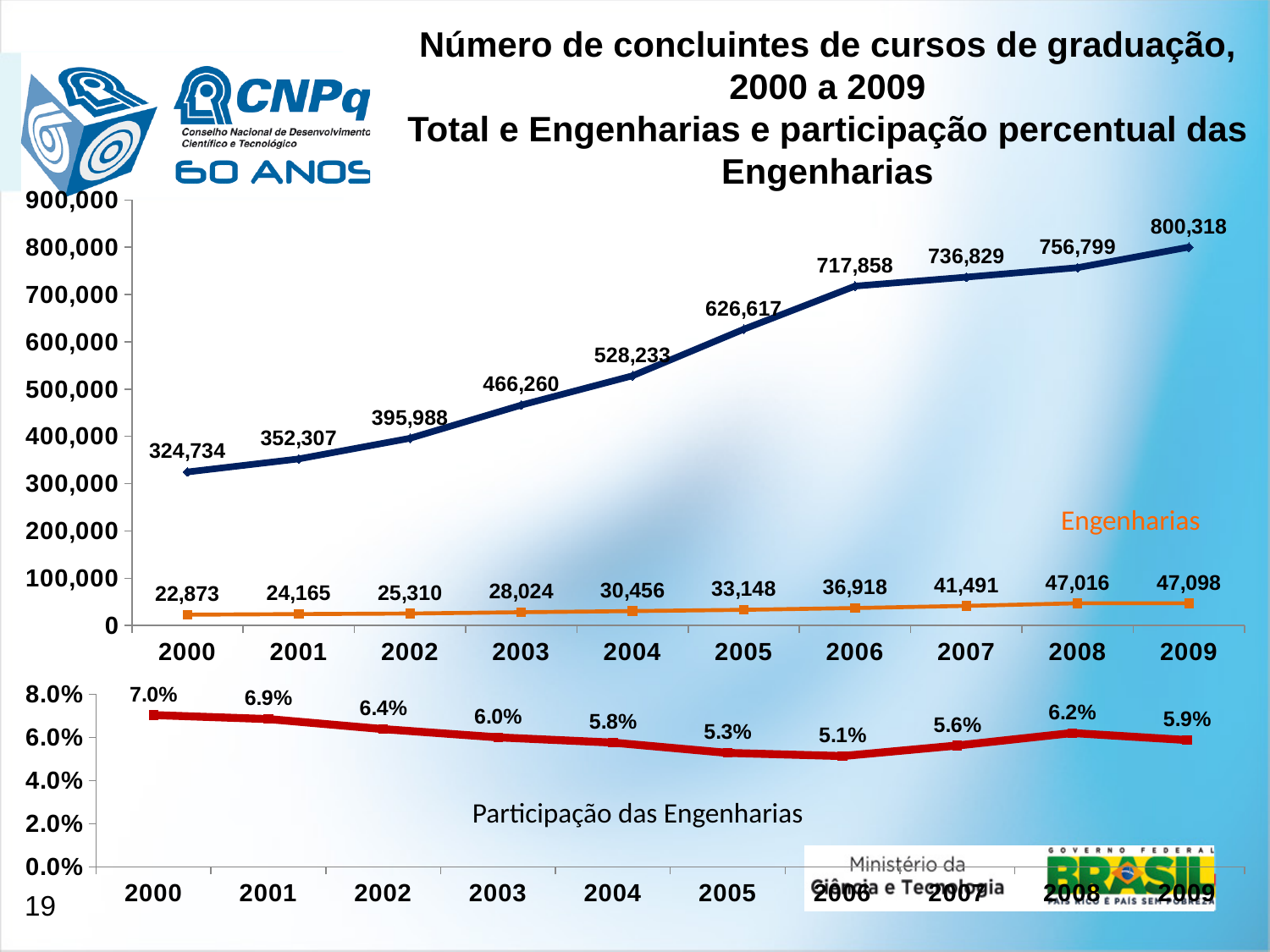
In the bottom chart, what is the Participação das Engenharias for 2007? 5.6% In the top chart, what is the label shown next to the orange line? Engenharias In the top chart, what is the Engenharias value for 2005? 33,148 How many years are plotted on the x axis of the top chart? 10 In the top chart, does the total (upper line) rise or fall from 2000 to 2009? Rises In the bottom chart, which year has the larger Participação das Engenharias, 2008 or 2009? 2008 In the bottom chart (Participação das Engenharias), which year has the lowest percentage? 2006 What kind of chart is the bottom chart (Participação das Engenharias)? Line chart In the top chart, by how much did the total (upper line) increase from 2000 to 2009? 475,584 In the bottom chart (Participação das Engenharias), which year has the highest percentage? 2000 In the top chart, what is the difference between the Engenharias values for 2009 and 2008? 82 In the top chart, what is the total number of concluintes in 2009? 800,318